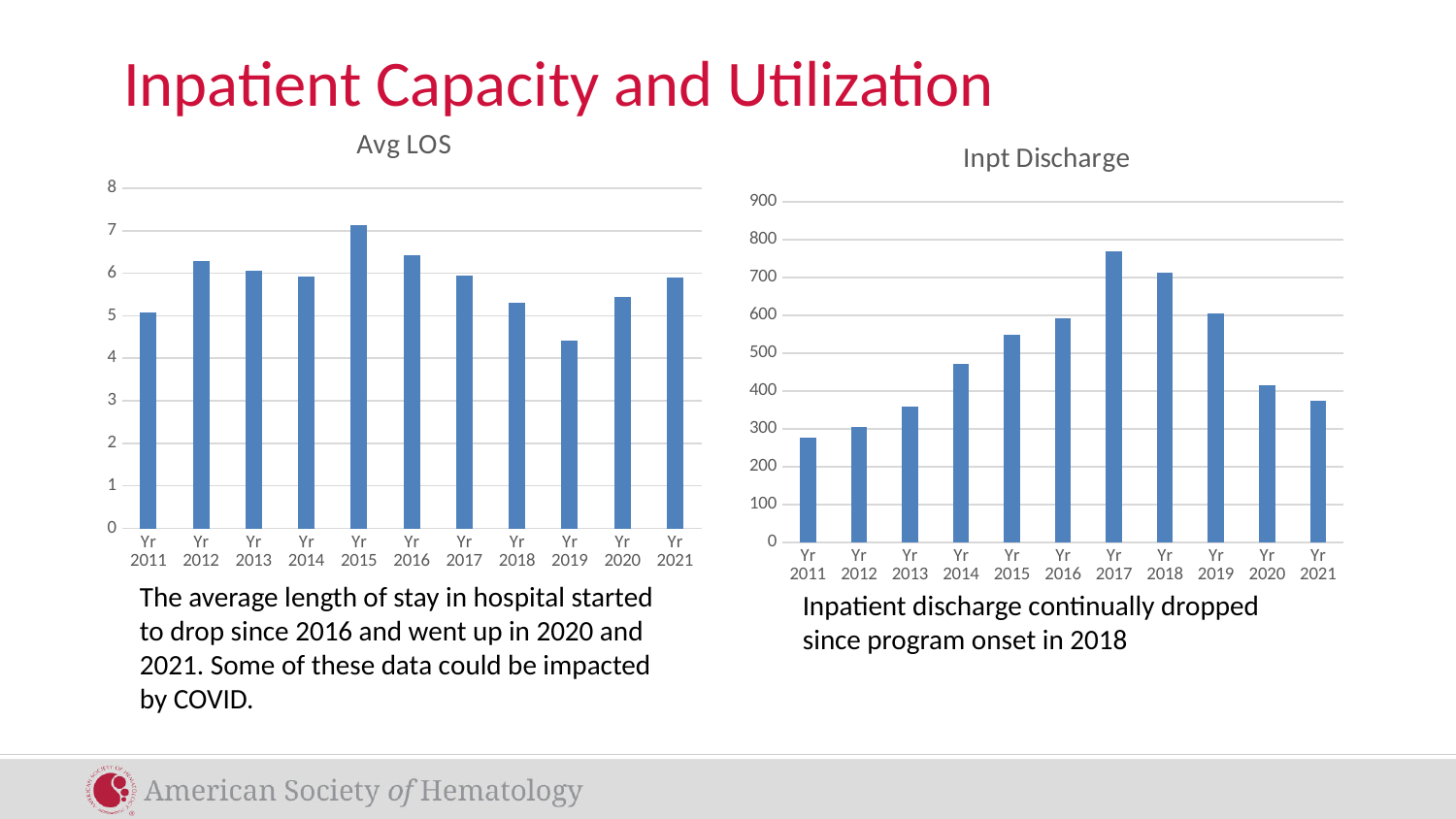
In the Avg LOS chart, is the value for Yr 2015 greater or less than 7? greater In the Avg LOS chart, which year has the highest average length of stay? Yr 2015 In the Inpt Discharge chart, do the values rise or fall from Yr 2017 to Yr 2021? fall In the Inpt Discharge chart, is the value for Yr 2017 greater or less than 700? greater In the Inpt Discharge chart, which year has the lowest number of inpatient discharges? Yr 2011 In the Inpt Discharge chart, is the value for Yr 2011 greater or less than 300? less How many years are shown on the x axis of the Avg LOS chart? 11 In the Avg LOS chart, which is larger, the value for Yr 2012 or Yr 2019? Yr 2012 What kind of chart is the Inpt Discharge chart? bar chart In the Avg LOS chart, which year has the lowest average length of stay? Yr 2019 In the Inpt Discharge chart, which year has the highest number of inpatient discharges? Yr 2017